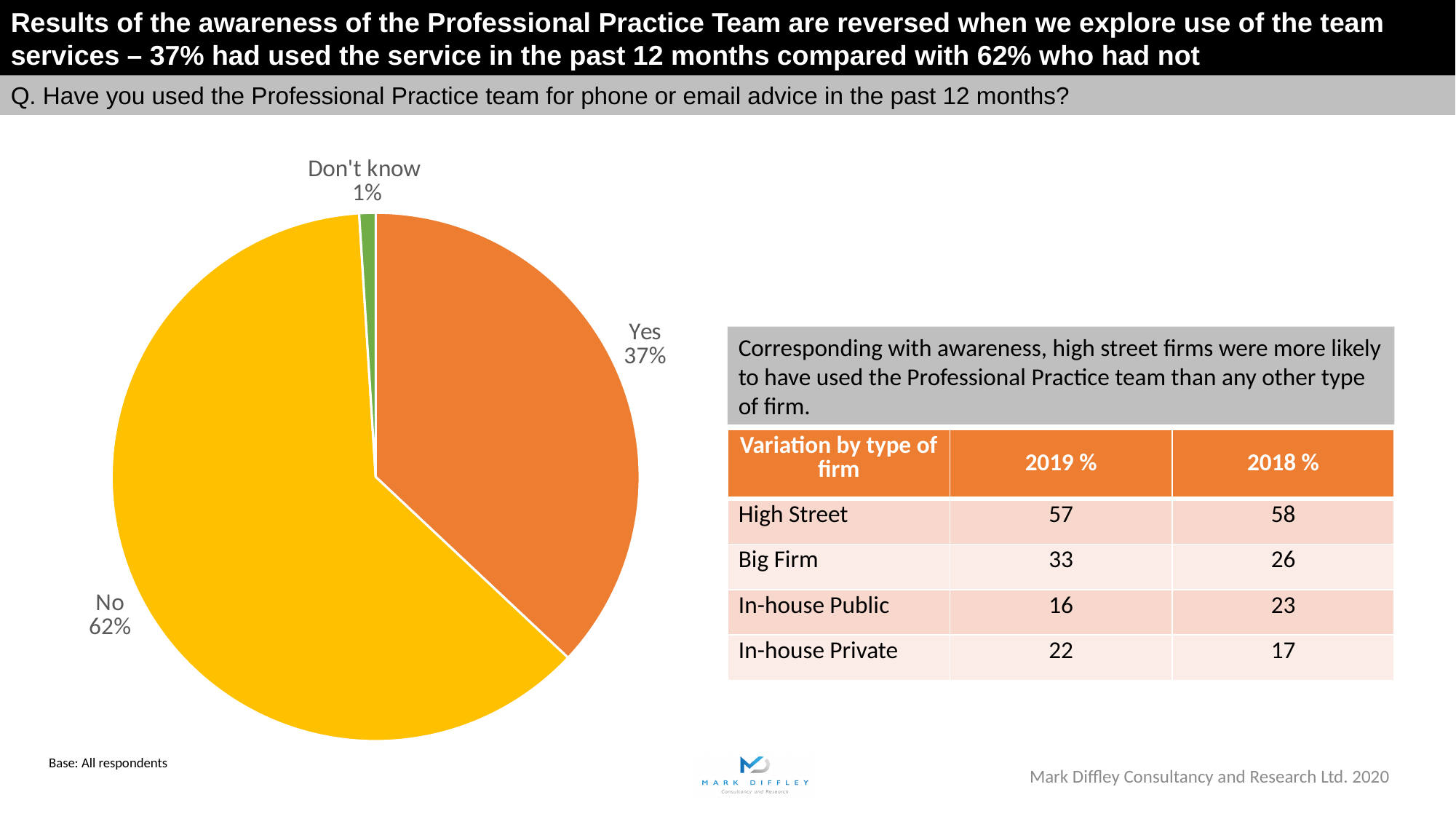
How many slices does the pie chart have? 3 Which is larger, the Yes slice or the No slice? No What percentage of respondents answered No? 62% What colour is the No slice of the pie chart? yellow What percentage of respondents answered Don't know? 1% Which response has the smallest share of the pie? Don't know What colour is the Yes slice of the pie chart? orange What percentage of respondents answered Yes? 37% Is the share for Yes greater or less than 50%? less What kind of chart is shown on the slide? pie chart What is the difference in percentage points between the No and Yes slices? 25 Which response has the largest share of the pie? No